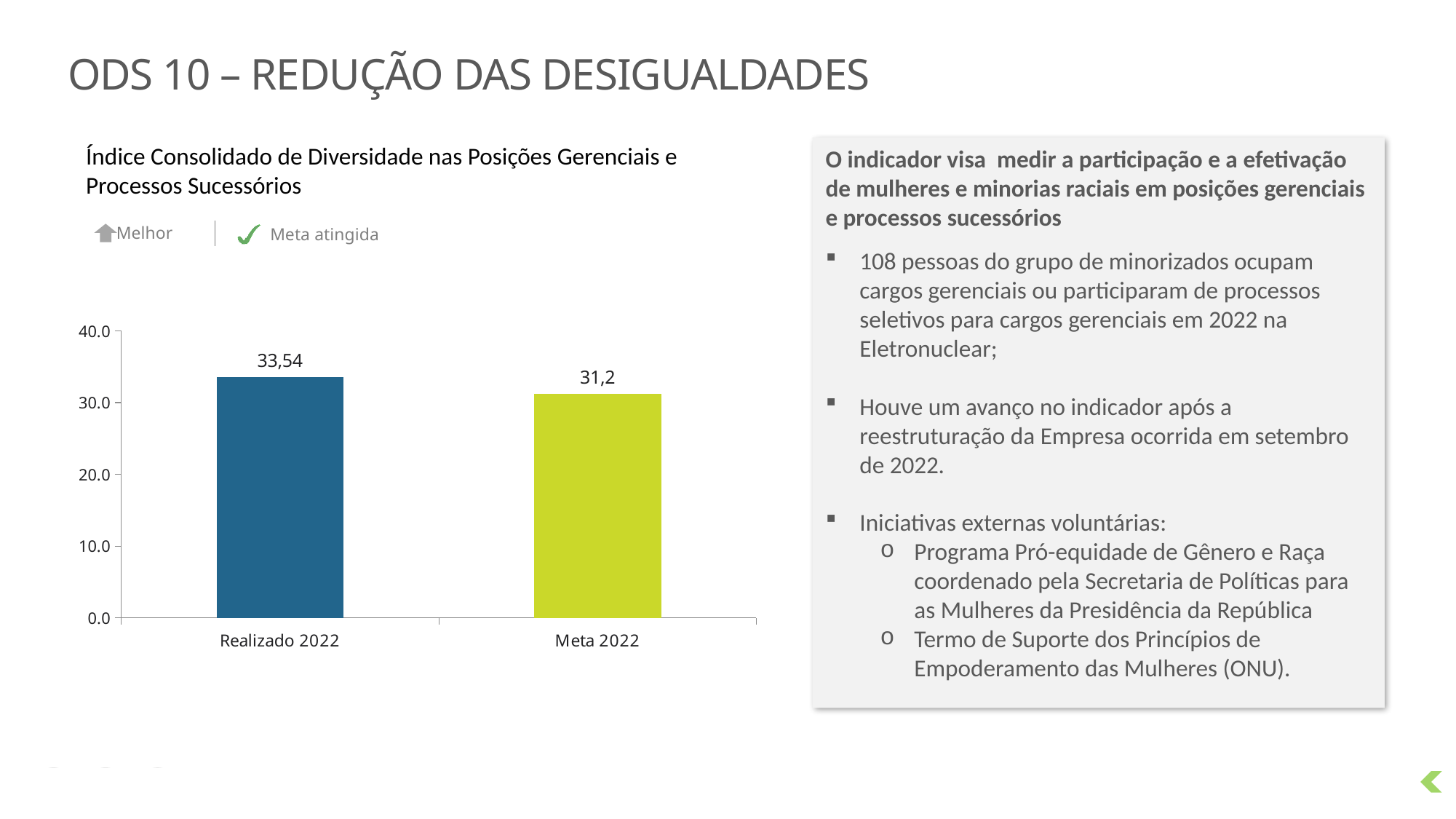
What colour is the Meta 2022 bar? yellow-green Is the value for Realizado 2022 greater or less than 40.0? less What is the value for Meta 2022? 31,2 Is the value for Meta 2022 greater or less than 30.0? greater Which category has the lowest value? Meta 2022 Which category has the highest value? Realizado 2022 What is the value for Realizado 2022? 33,54 Which is larger, Realizado 2022 or Meta 2022? Realizado 2022 What is the title of the chart? Índice Consolidado de Diversidade nas Posições Gerenciais e Processos Sucessórios How many categories are shown on the x axis? 2 What kind of chart is shown on the slide? bar chart What is the difference between the Realizado 2022 and Meta 2022 values? 2,34